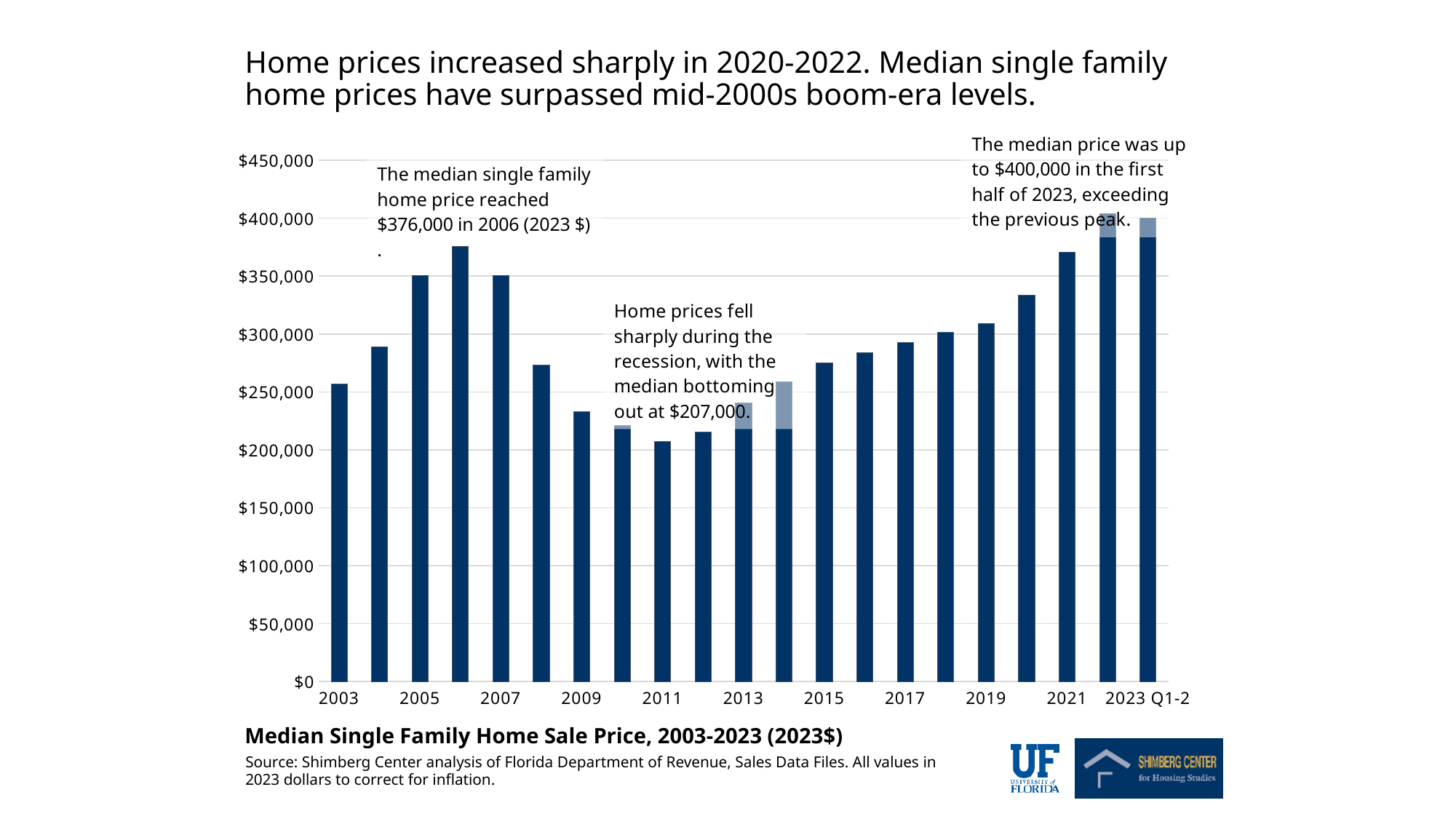
According to the annotation, what median single family home price was reached in 2006 (2023 $)? $376,000 Which year has the lowest median home sale price? 2011 Is the value for 2016 greater or less than $300,000? less Is the value for 2009 greater or less than $250,000? less How many bars (years) are plotted in the chart? 21 According to the annotation, what was the median price in the first half of 2023? $400,000 Do median home prices rise or fall from 2011 to 2022? Rise What is the title of the chart? Median Single Family Home Sale Price, 2003-2023 (2023$) Which year has the higher median home sale price, 2006 or 2007? 2006 What kind of chart is shown on the slide? Bar chart According to the annotation, at what value did the median home price bottom out during the recession? $207,000 Is the value for 2021 greater or less than $350,000? greater